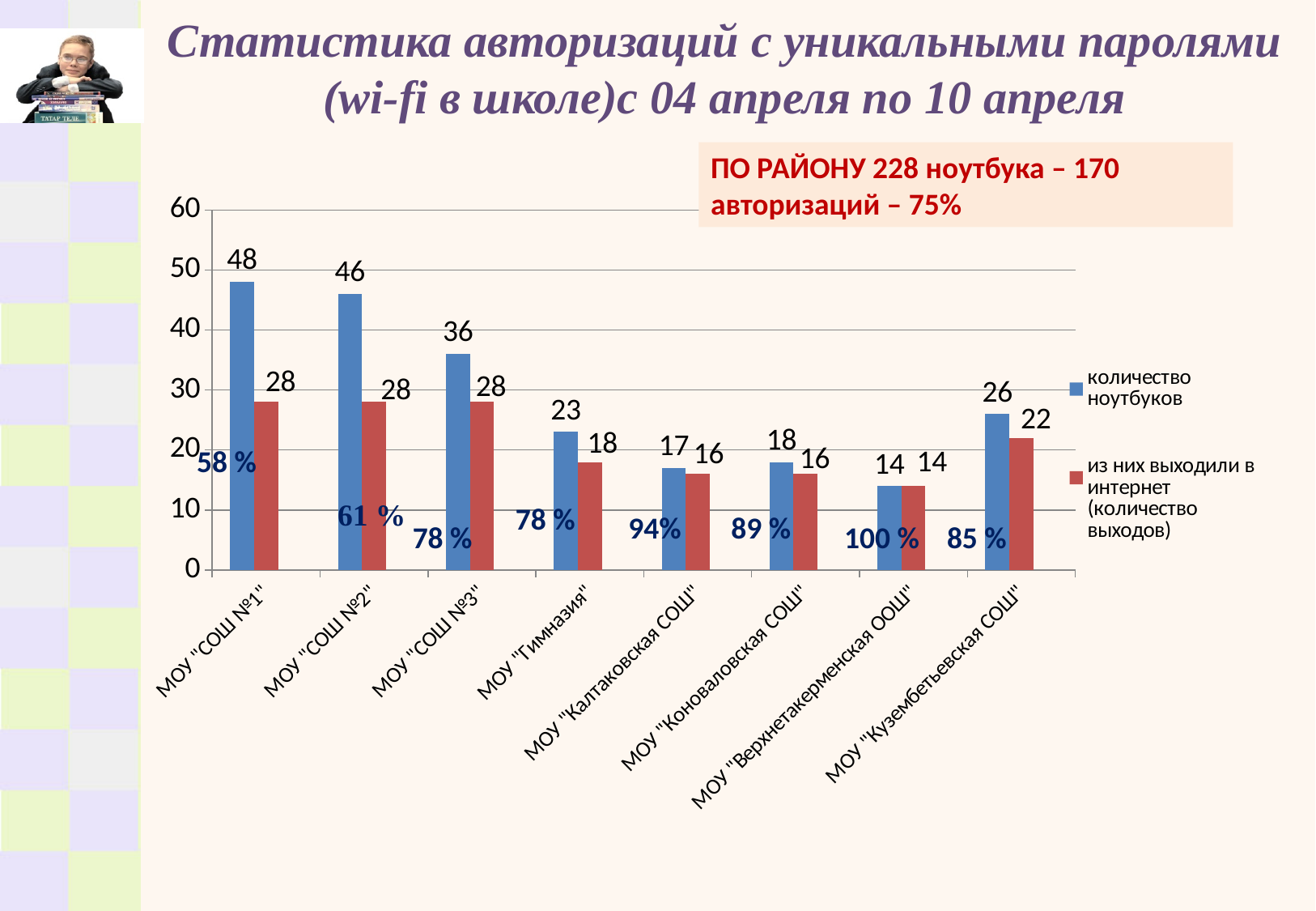
How many categories are shown on the x axis? 8 Which is larger: "из них выходили в интернет (количество выходов)" for МОУ "СОШ №3" or for МОУ "Кузембетьевская СОШ"? МОУ "СОШ №3" What kind of chart is shown on the slide? bar chart What is the value of "из них выходили в интернет (количество выходов)" for МОУ "Гимназия"? 18 What is the value of "количество ноутбуков" for МОУ "СОШ №1"? 48 How many series does the legend list? 2 What is the value of "количество ноутбуков" for МОУ "Кузембетьевская СОШ"? 26 Which category has the lowest value for "количество ноутбуков"? МОУ "Верхнетакерменская ООШ" What colour are the bars for the series "количество ноутбуков"? blue Which category has the highest value for "количество ноутбуков"? МОУ "СОШ №1" What is the difference between "количество ноутбуков" and "из них выходили в интернет (количество выходов)" for МОУ "СОШ №2"? 18 What percentage is printed on the chart for МОУ "Калтаковская СОШ"? 94%